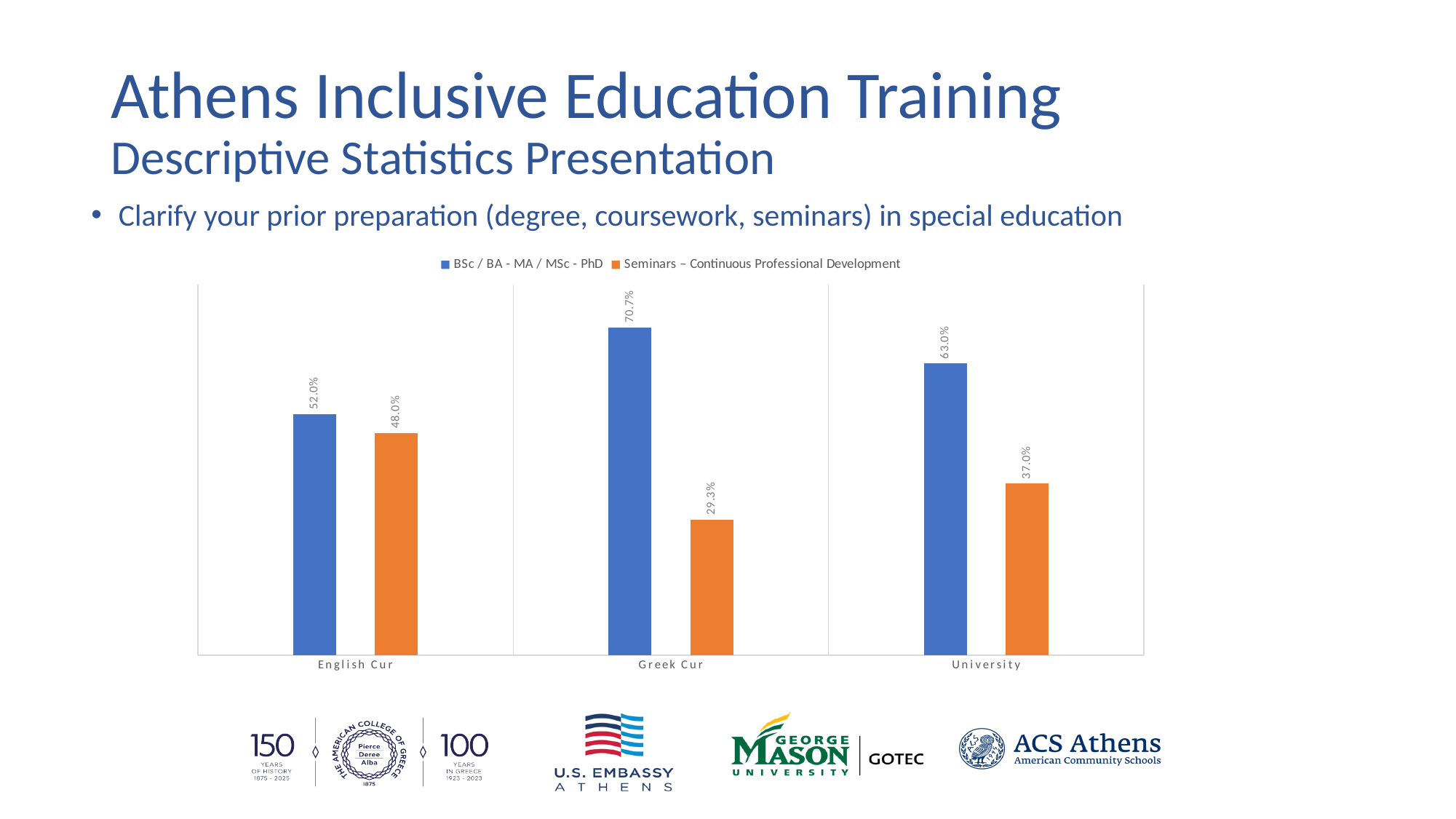
Which category has the lowest value for Seminars – Continuous Professional Development? Greek Cur How many series does the legend list? 2 Which category has the highest value for BSc / BA - MA / MSc - PhD? Greek Cur How many categories are shown on the x axis? 3 What is the value for BSc / BA - MA / MSc - PhD in the Greek Cur category? 70.7% What is the value for Seminars – Continuous Professional Development in the English Cur category? 48.0% Which colour represents the Seminars – Continuous Professional Development series? Orange What is the difference between the BSc / BA - MA / MSc - PhD and Seminars – Continuous Professional Development values in the University category? 26.0% What is the total of the two series values in the Greek Cur category? 100.0% Which is larger in the English Cur category: BSc / BA - MA / MSc - PhD or Seminars – Continuous Professional Development? BSc / BA - MA / MSc - PhD What is the value for Seminars – Continuous Professional Development in the University category? 37.0% What kind of chart is shown on the slide? Bar chart